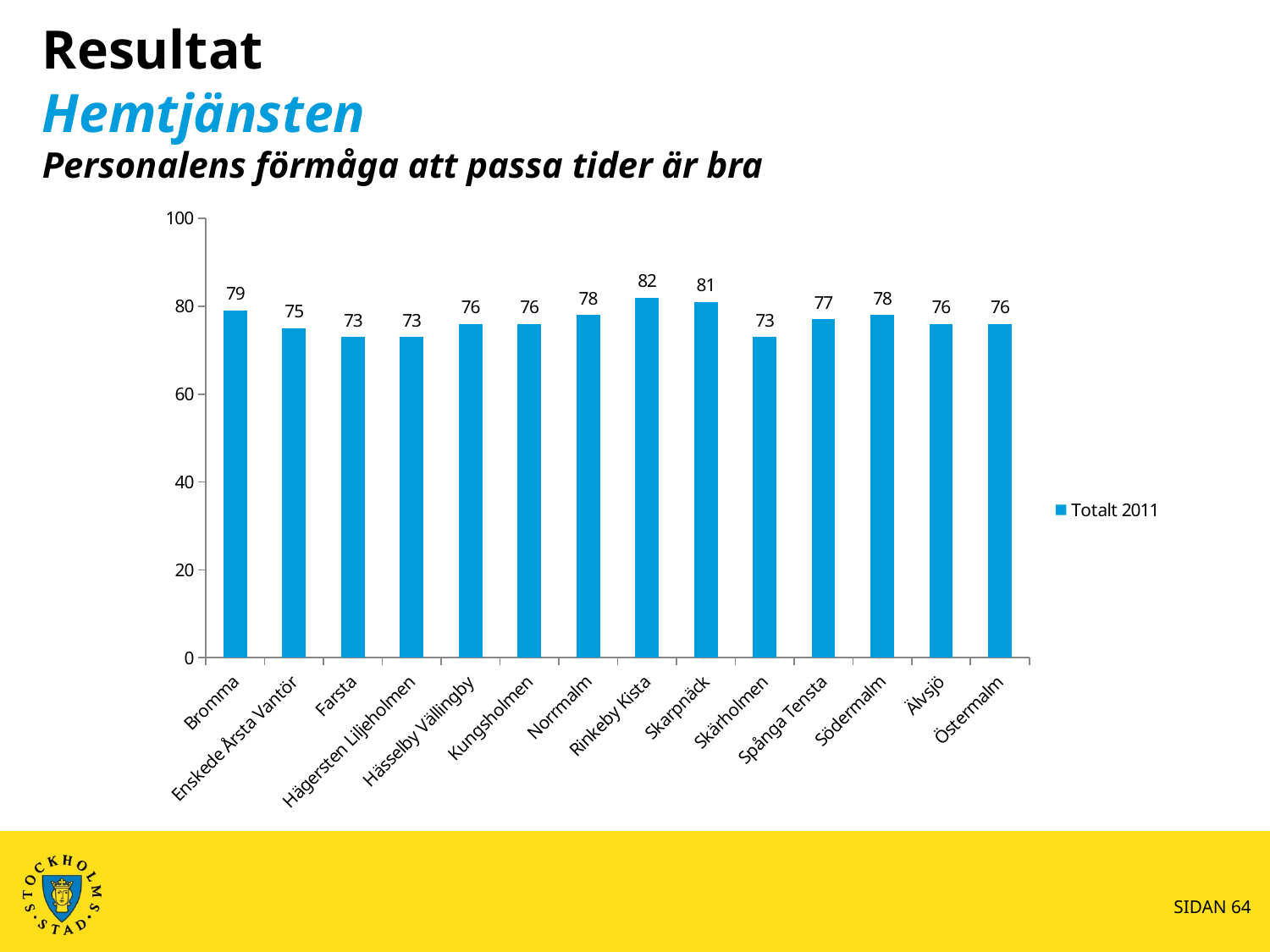
Which has a higher value, Bromma or Norrmalm? Bromma Is the value for Skärholmen greater or less than 80? less What is the value for Bromma? 79 What kind of chart is shown on the slide? Bar chart What is the value for Spånga Tensta? 77 How many categories are shown on the x axis? 14 Which category has the highest value? Rinkeby Kista How many series does the legend list? 1 What is the value for Skarpnäck? 81 What is the difference between the values for Rinkeby Kista and Farsta? 9 What is the value for Enskede Årsta Vantör? 75 What is the lowest value shown in the chart? 73